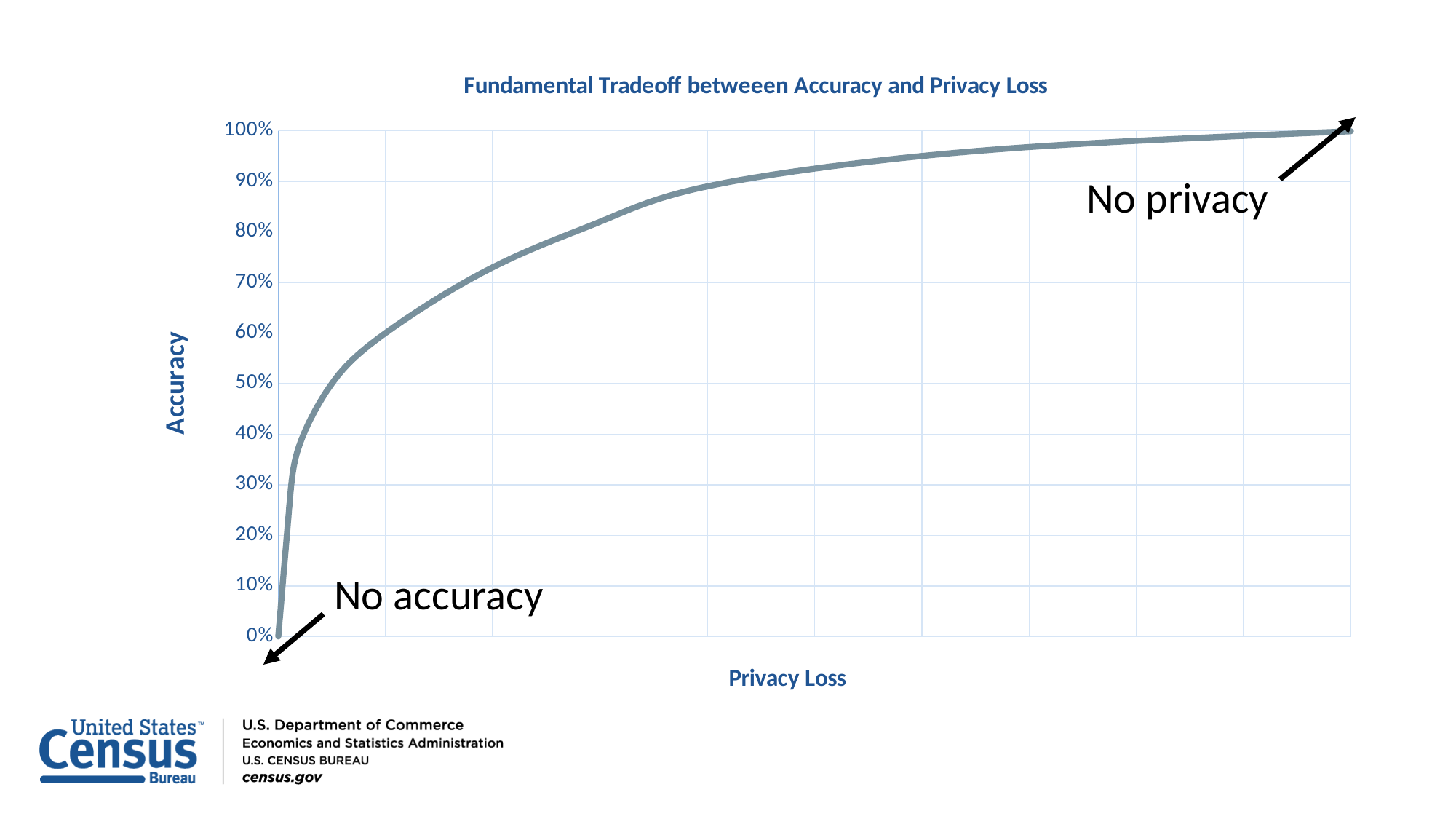
What is the lowest value shown on the vertical axis? 0% What is the highest value shown on the vertical axis? 100% Is the accuracy at the right end of the curve greater or less than 90%? greater What kind of chart is shown on the slide? line chart What is the title of the chart? Fundamental Tradeoff betweeen Accuracy and Privacy Loss Which end of the curve has the higher accuracy, the left end or the right end? right end How many lines are plotted on the chart? 1 Does accuracy rise or fall as privacy loss increases along the x axis? rise Is the accuracy at the left end of the curve greater or less than 10%? less What is the label on the horizontal axis of the chart? Privacy Loss What accuracy value does the curve start at on the far left of the chart? 0%